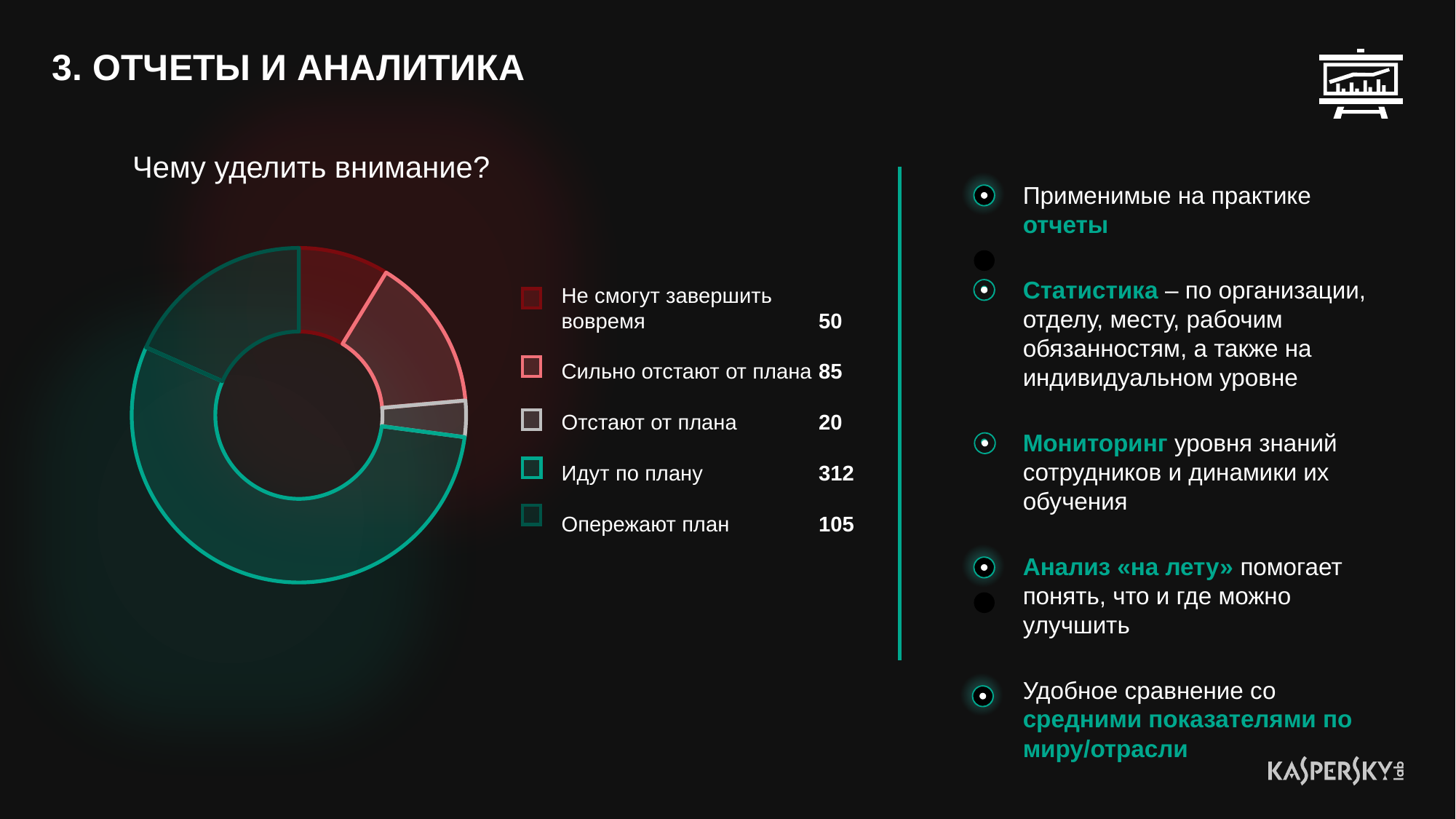
What value is shown for «Опережают план»? 105 Which is larger: «Сильно отстают от плана» or «Не смогут завершить вовремя»? Сильно отстают от плана What value is shown for «Идут по плану»? 312 How many categories does the chart show? 5 What is the difference between «Сильно отстают от плана» and «Отстают от плана»? 65 Which category has the lowest value? Отстают от плана Which category has the highest value? Идут по плану What value is shown for «Сильно отстают от плана»? 85 What is the heading above the chart? Чему уделить внимание? What value is shown for «Не смогут завершить вовремя»? 50 What is the difference between «Идут по плану» and «Опережают план»? 207 What kind of chart is shown on the slide? Donut (pie) chart